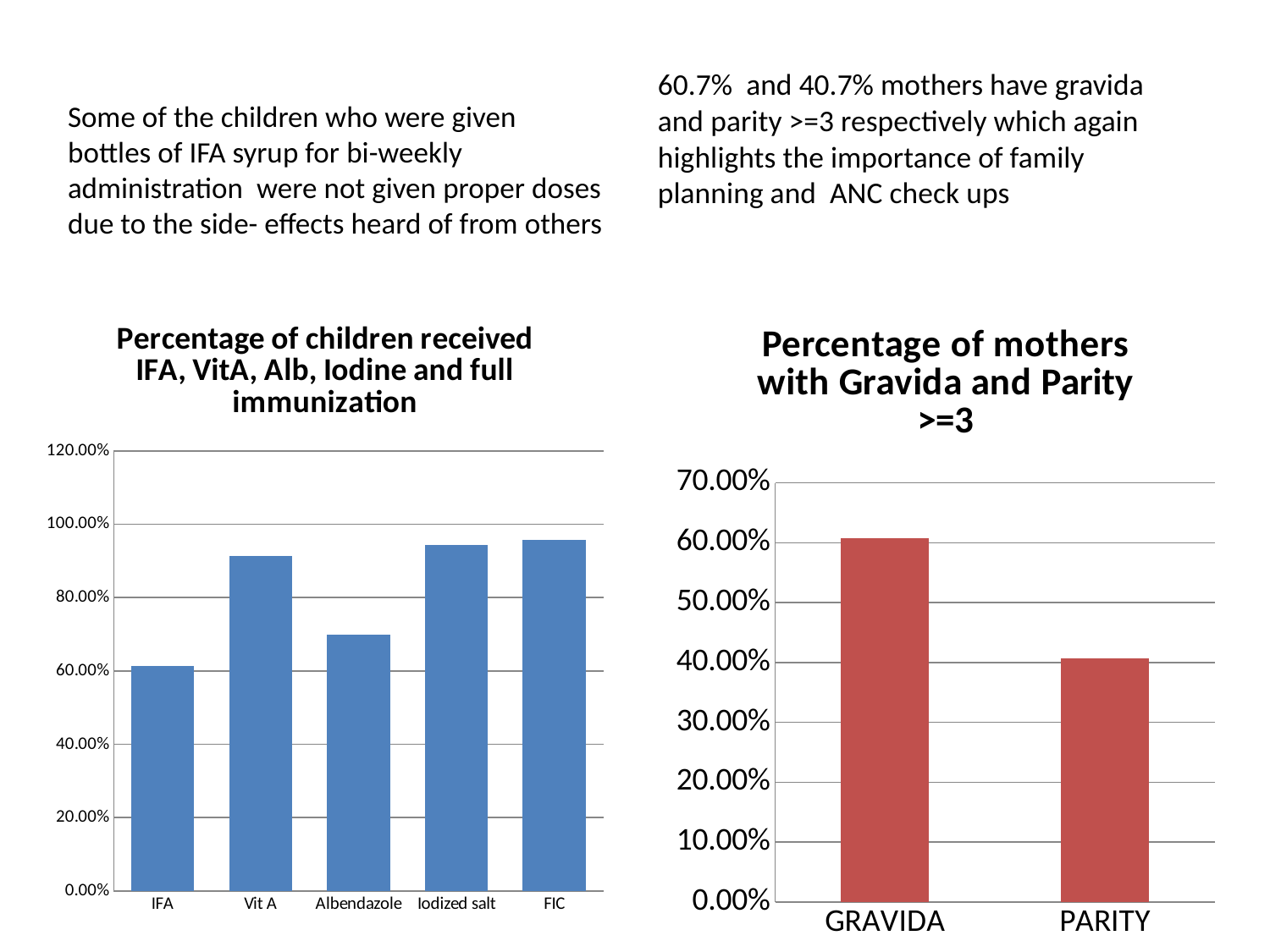
What kind of chart is the left chart (Percentage of children received IFA, VitA, Alb, Iodine and full immunization)? bar chart On the right chart (Percentage of mothers with Gravida and Parity >=3), how many categories are shown on the x axis? 2 On the left chart (Percentage of children received IFA, VitA, Alb, Iodine and full immunization), is the value for Albendazole greater or less than 80.00%? less On the left chart (Percentage of children received IFA, VitA, Alb, Iodine and full immunization), how many categories are shown on the x axis? 5 On the right chart (Percentage of mothers with Gravida and Parity >=3), which category has the highest value? GRAVIDA On the left chart (Percentage of children received IFA, VitA, Alb, Iodine and full immunization), which category has the lowest value? IFA On the left chart (Percentage of children received IFA, VitA, Alb, Iodine and full immunization), is the value for Vit A greater or less than 80.00%? greater On the left chart (Percentage of children received IFA, VitA, Alb, Iodine and full immunization), is the value for Iodized salt greater or less than 80.00%? greater On the left chart (Percentage of children received IFA, VitA, Alb, Iodine and full immunization), which is larger, the value for Albendazole or the value for IFA? Albendazole What colour are the bars on the right chart (Percentage of mothers with Gravida and Parity >=3)? red